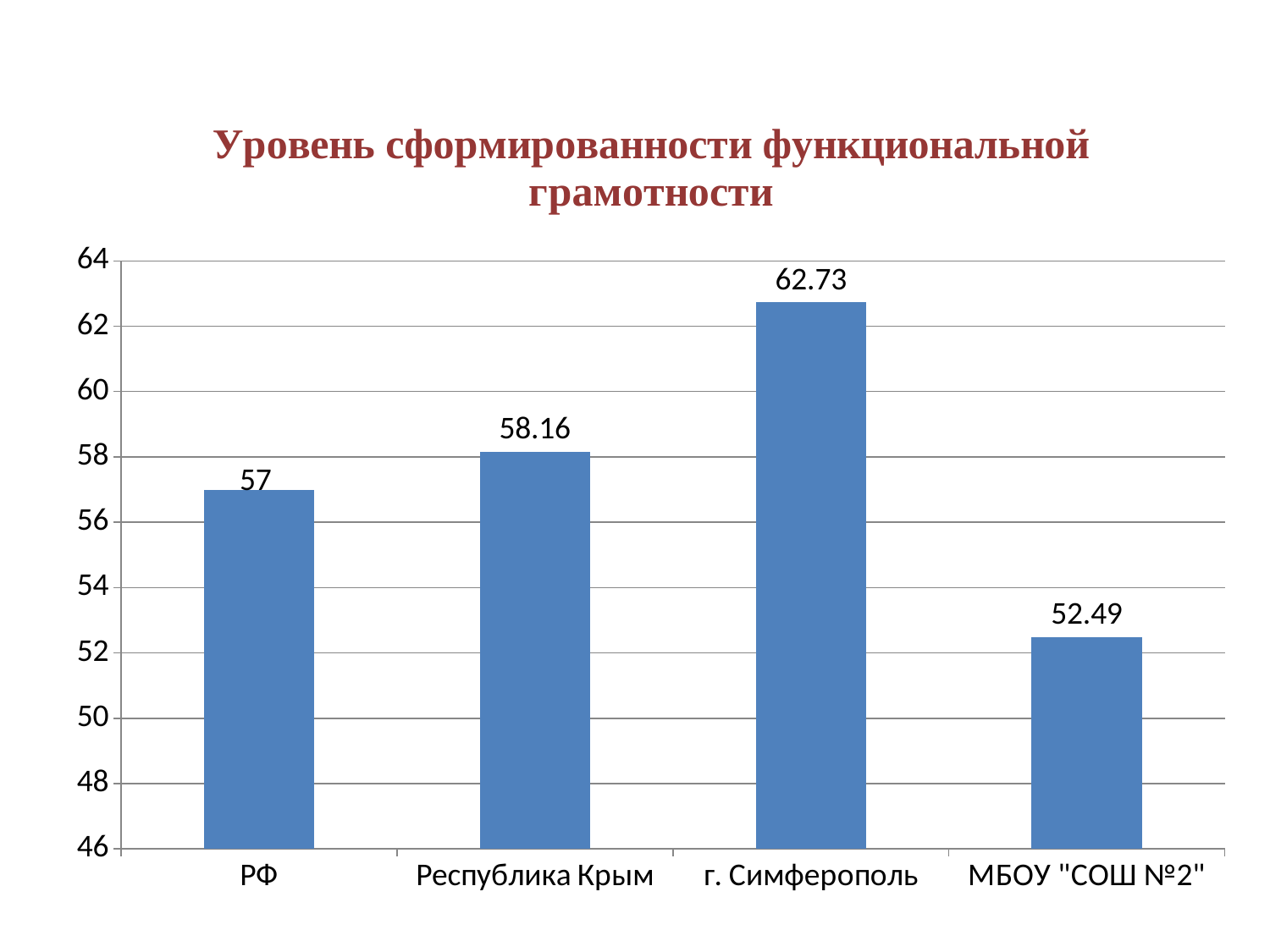
What is the value for г. Симферополь? 62.73 What is the value for Республика Крым? 58.16 Is the value for МБОУ "СОШ №2" greater or less than 54? less What is the value for РФ? 57 How many categories are shown on the chart? 4 Which category has the lowest value? МБОУ "СОШ №2" Which is larger, the value for Республика Крым or the value for РФ? Республика Крым What is the difference between the values for г. Симферополь and РФ? 5.73 What is the difference between the values for Республика Крым and МБОУ "СОШ №2"? 5.67 What type of chart is shown on the slide? bar chart What is the value for МБОУ "СОШ №2"? 52.49 Which category has the highest value? г. Симферополь